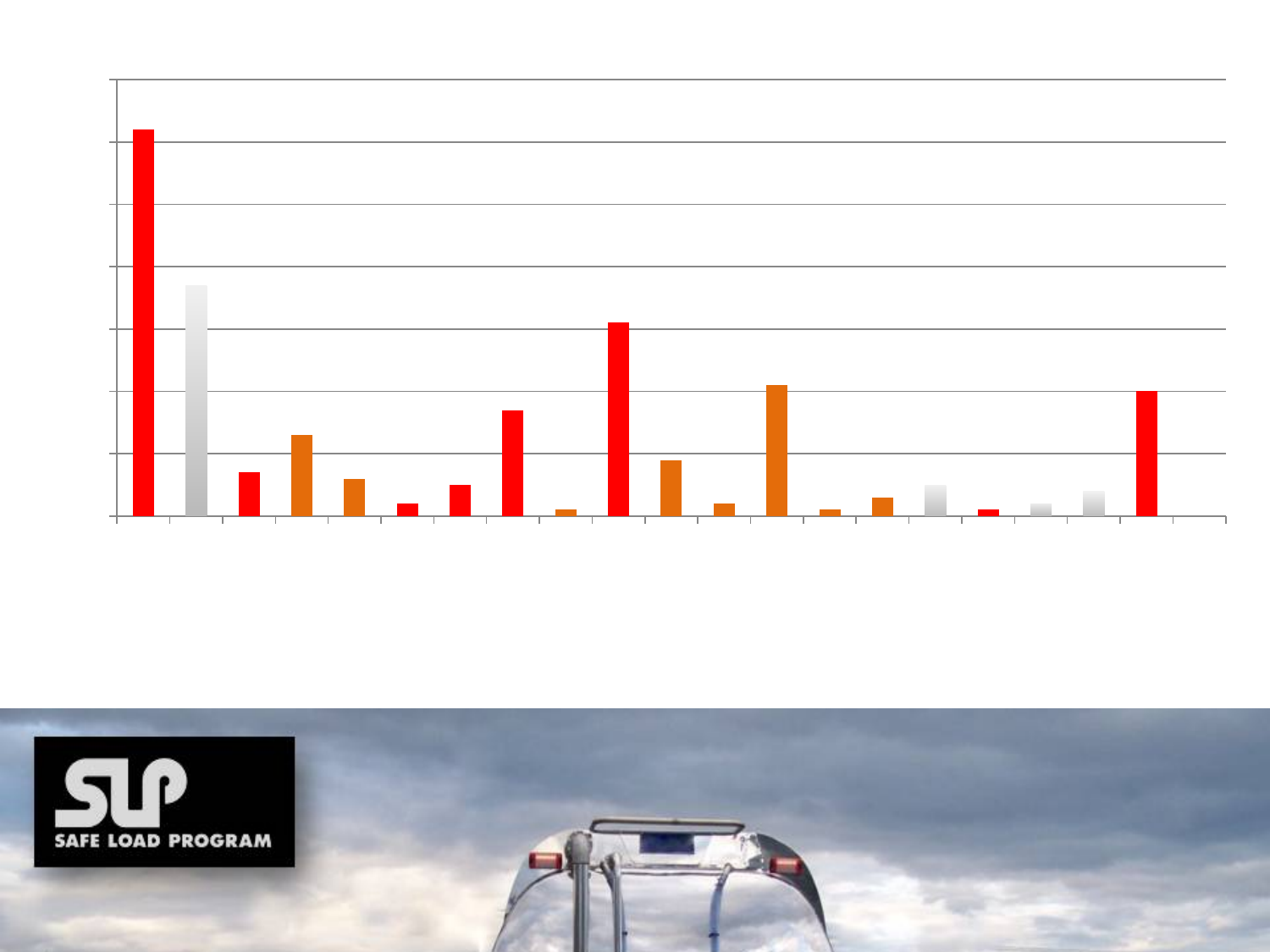
Which is taller, the second bar from the left (grey) or the rightmost bar (red)? the second bar from the left Which bar is the tallest in the chart, by position? the leftmost bar What colour is the tallest bar in the chart? red How many bars are plotted in the chart? 20 What kind of chart is shown on the slide? bar chart Which is taller, the leftmost bar or the rightmost bar? the leftmost bar What colours are used for the bars in the chart? red, grey and orange